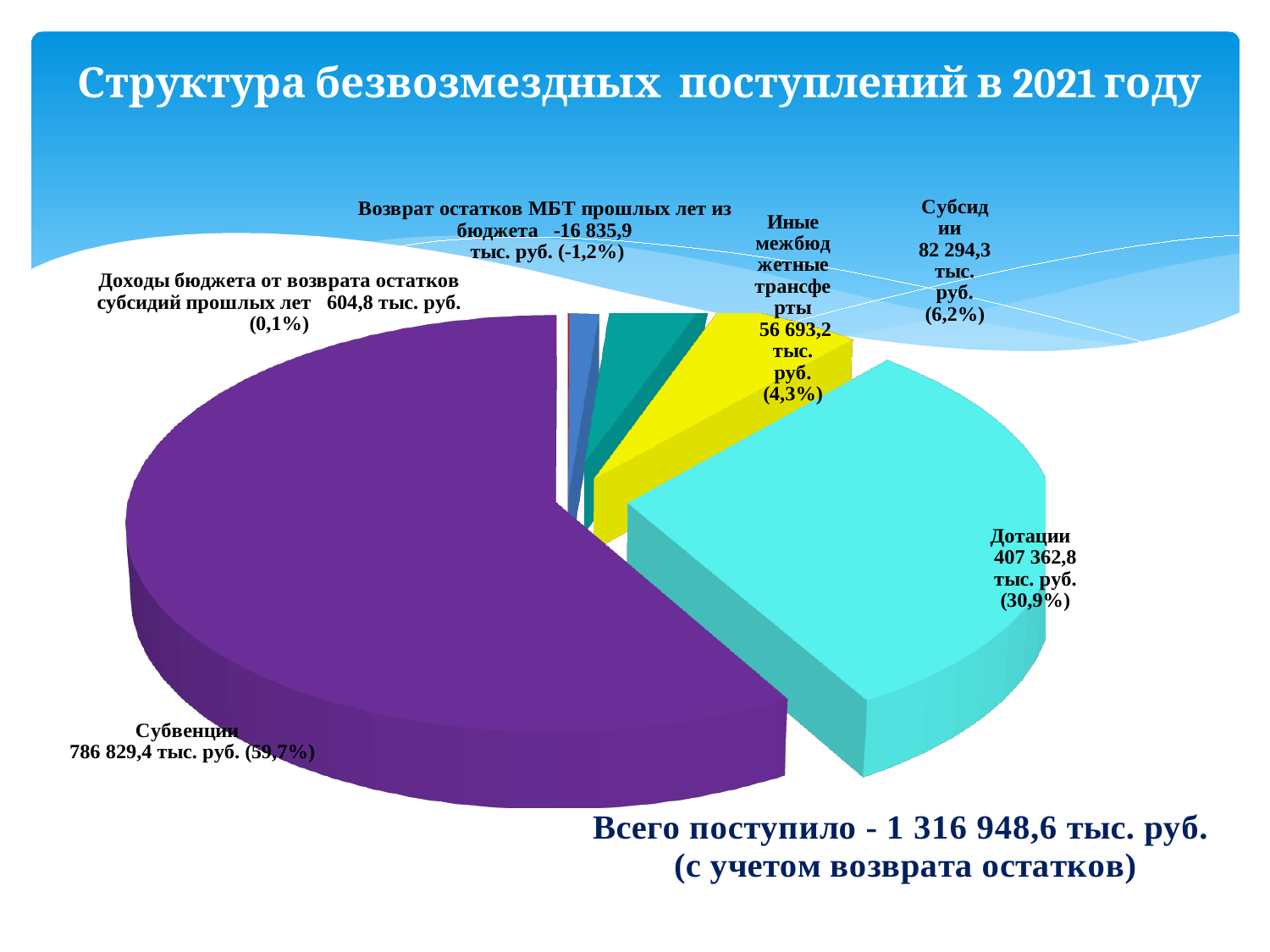
What is the value for Субсидии? 82 294,3 тыс. руб. Which category has the smallest value? Возврат остатков МБТ прошлых лет из бюджета What share of the pie does Дотации represent? 30,9% What is the value for Дотации? 407 362,8 тыс. руб. Which is larger, Субсидии or Иные межбюджетные трансферты? Субсидии What is the value for Субвенции? 786 829,4 тыс. руб. What kind of chart is shown on the slide? pie chart What share of the pie does Субвенции represent? 59,7% What is the value for Иные межбюджетные трансферты? 56 693,2 тыс. руб. Which category has the largest value? Субвенции What is the title of the chart? Всего поступило - 1 316 948,6 тыс. руб. (с учетом возврата остатков) How many categories are shown in the pie chart? 6